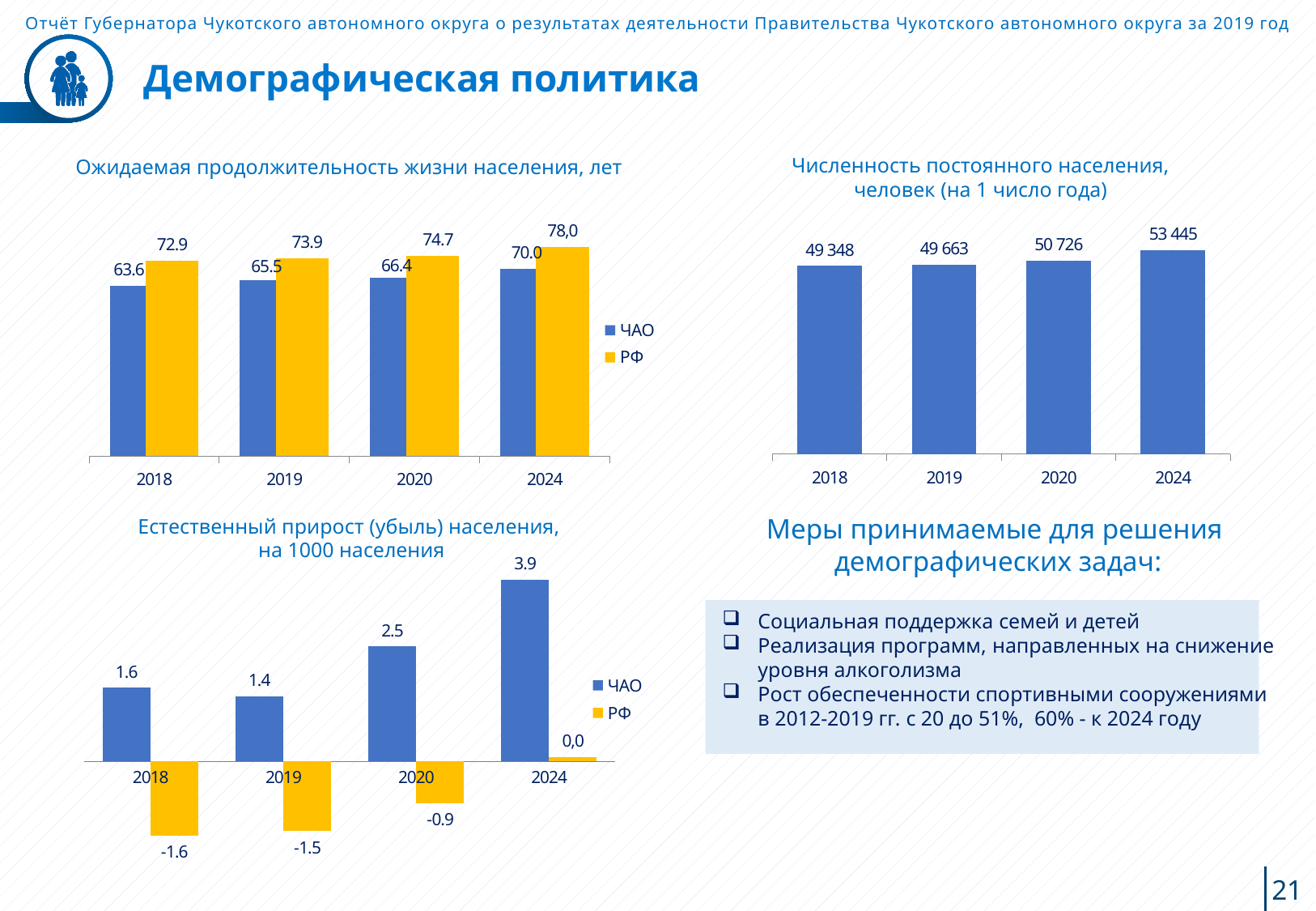
In the chart 'Численность постоянного населения, человек (на 1 число года)', what is the value for 2020? 50 726 What type of chart is 'Численность постоянного населения, человек (на 1 число года)'? bar chart In the chart 'Естественный прирост (убыль) населения, на 1000 населения', which is larger in 2020: ЧАО or РФ? ЧАО In the chart 'Численность постоянного населения, человек (на 1 число года)', how many years are shown? 4 In the chart 'Ожидаемая продолжительность жизни населения, лет', what is the difference between РФ and ЧАО in 2020? 8.3 In the chart 'Ожидаемая продолжительность жизни населения, лет', what is the value for ЧАО in 2018? 63.6 In the chart 'Ожидаемая продолжительность жизни населения, лет', how many series does the legend list? 2 In the chart 'Численность постоянного населения, человек (на 1 число года)', which year has the highest value? 2024 In the chart 'Ожидаемая продолжительность жизни населения, лет', what is the value for РФ in 2024? 78,0 In the chart 'Численность постоянного населения, человек (на 1 число года)', do the values rise or fall from 2018 to 2024? rise In the chart 'Естественный прирост (убыль) населения, на 1000 населения', which year has the lowest value for ЧАО? 2019 In the chart 'Естественный прирост (убыль) населения, на 1000 населения', what is the value for РФ in 2018? -1.6